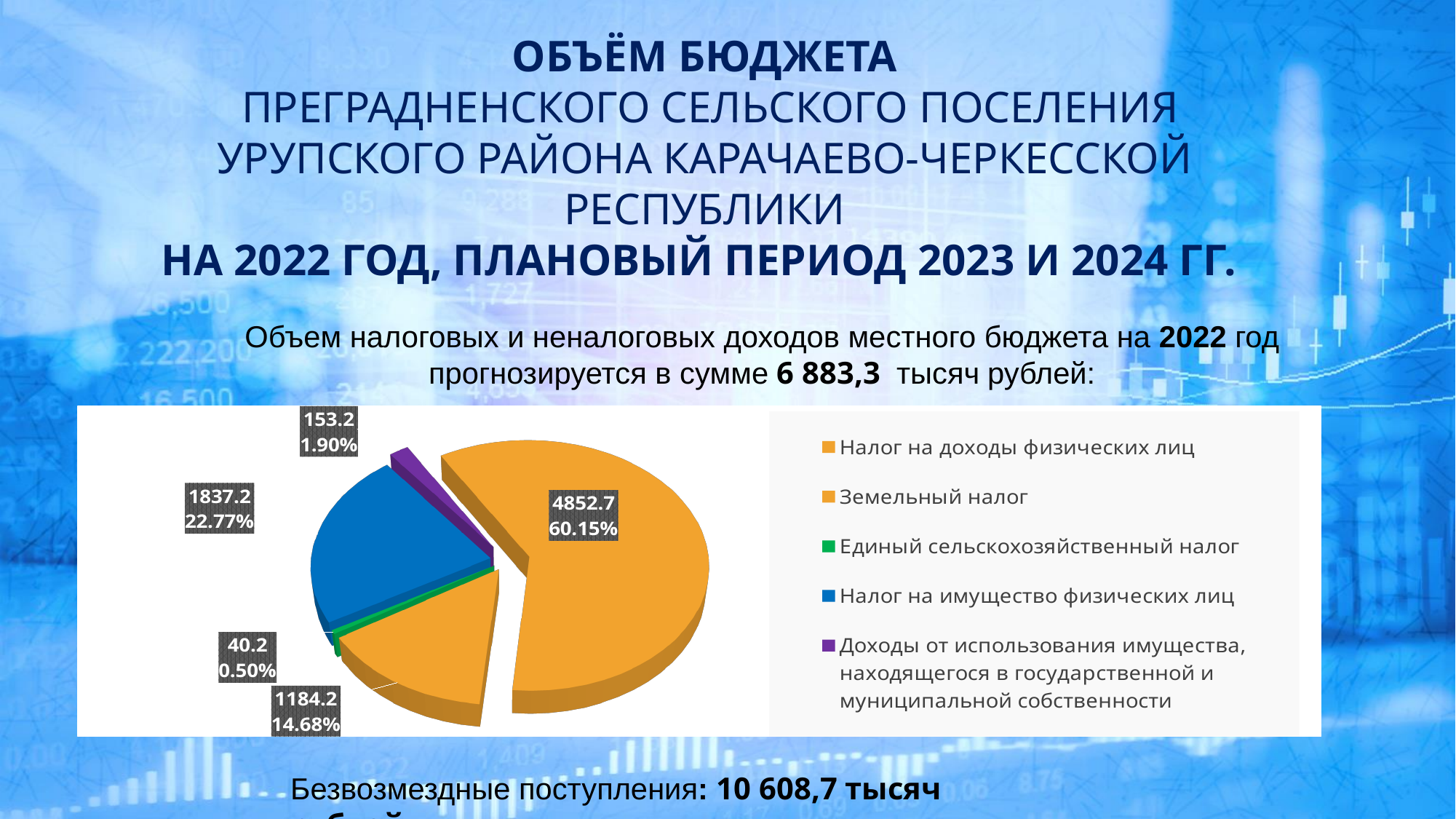
How many slices does the pie chart have? 5 What is the value shown for Налог на доходы физических лиц? 4852.7 Which category has the smallest slice in the pie chart? Единый сельскохозяйственный налог How many entries does the legend of the pie chart list? 5 What share of the pie does Доходы от использования имущества, находящегося в государственной и муниципальной собственности represent? 1.90% What kind of chart is shown on the slide? pie chart What is the value shown for Земельный налог? 1184.2 What is the difference between the values for Налог на имущество физических лиц and Земельный налог? 653.0 What is the value shown for Налог на имущество физических лиц? 1837.2 What share of the pie does Налог на доходы физических лиц represent? 60.15% Which category has the largest slice in the pie chart? Налог на доходы физических лиц What is the value shown for Единый сельскохозяйственный налог? 40.2